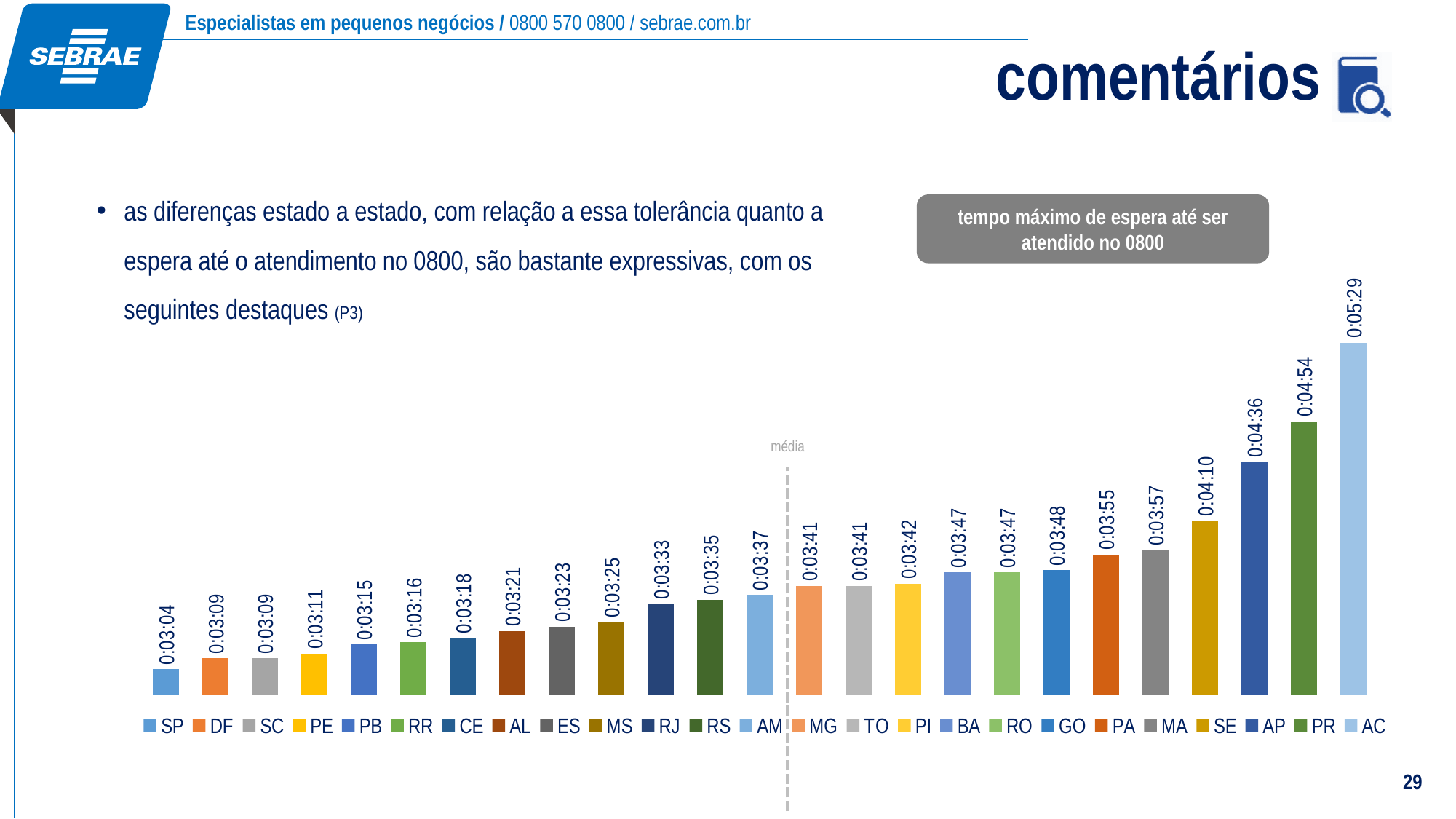
What is the value for AC? 0:05:29 What kind of chart is shown on the slide? bar chart What is the value for SP? 0:03:04 What is the value for SE? 0:04:10 Which state has the highest maximum waiting time? AC What is the difference between the values for PR and AP? 0:00:18 What is the difference between the values for AC and SP? 0:02:25 How many states are shown in the chart? 25 Do the values rise or fall from left to right along the x axis? rise What is the value for GO? 0:03:48 Which is larger, the value for PA or the value for MS? PA Which state has the lowest maximum waiting time? SP